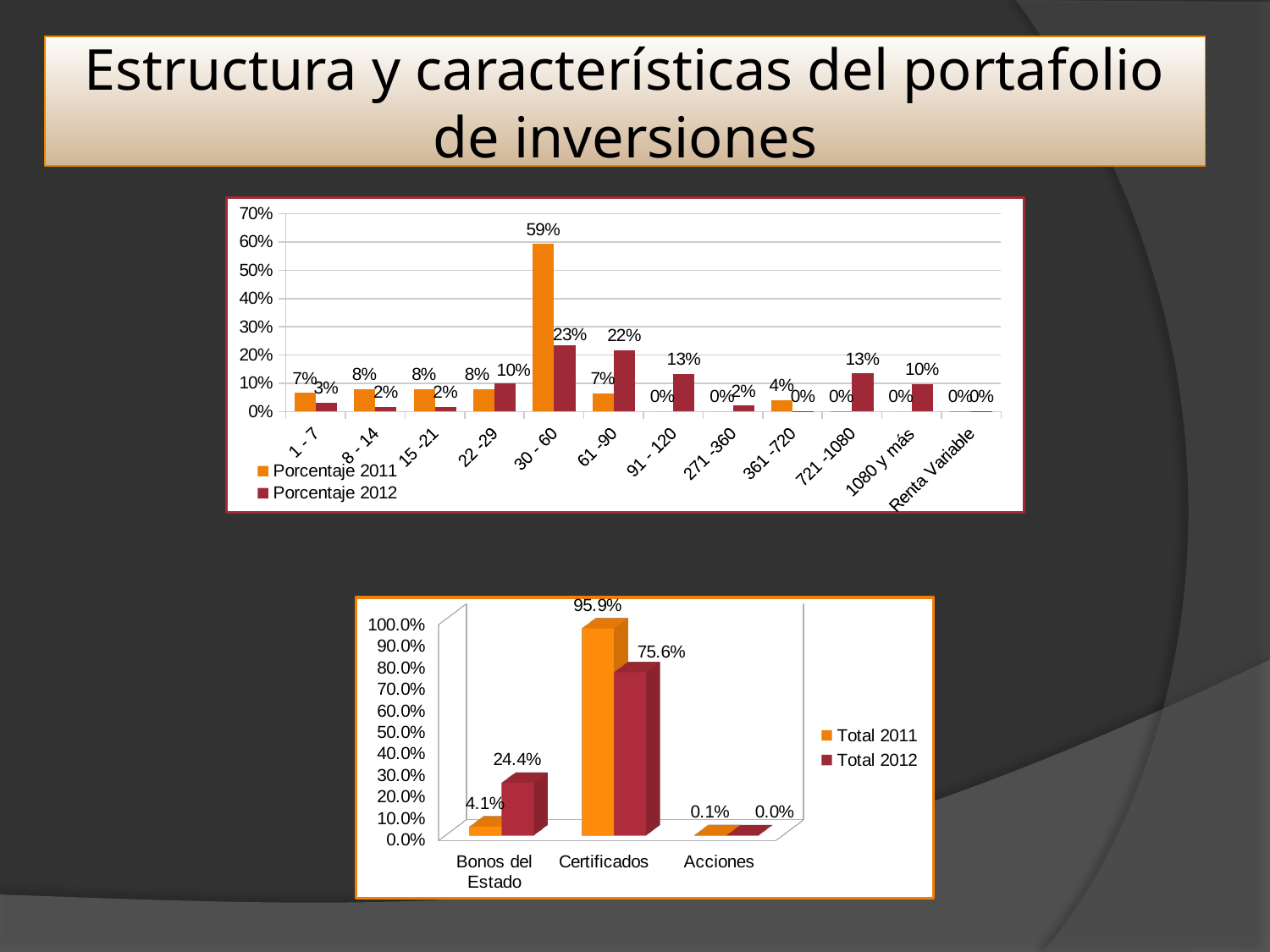
In the top chart, which is larger for the 22 - 29 category: Porcentaje 2011 or Porcentaje 2012? Porcentaje 2012 In the top chart, how many categories are shown on the x axis? 12 In the top chart, what is the Porcentaje 2012 value for the 61 - 90 category? 22% In the bottom chart, what is the Total 2012 value for Bonos del Estado? 24.4% In the top chart, what is the Porcentaje 2011 value for the 30 - 60 category? 59% In the top chart, how many series does the legend list? 2 In the top chart, what is the difference between the Porcentaje 2011 and Porcentaje 2012 values for the 30 - 60 category? 36% In the bottom chart, what is the difference between the Total 2011 and Total 2012 values for Certificados? 20.3% In the bottom chart, which category has the lowest Total 2011 value? Acciones In the bottom chart, what is the Total 2011 value for Certificados? 95.9% What kind of chart is the bottom chart? Bar chart In the top chart, which category has the highest Porcentaje 2011 value? 30 - 60